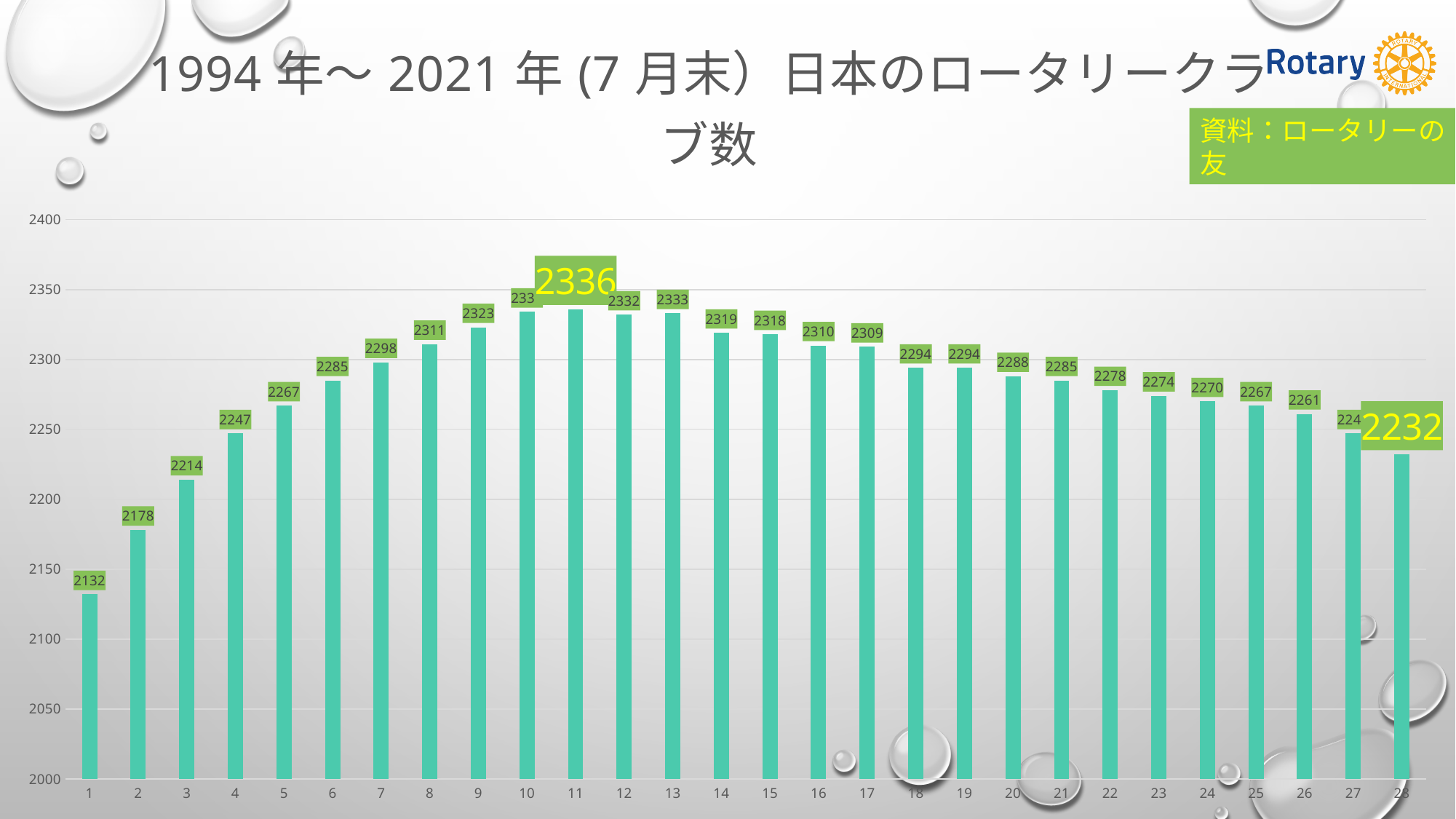
Which is larger, the value for category 5 or the value for category 22? category 22 What is the value for category 28? 2232 What is the value for category 1? 2132 How many bars (categories) are plotted on the chart? 28 What is the value for category 11? 2336 Which category has the highest value? 11 Which category has the lowest value? 1 Is the value for category 3 greater or less than 2200? greater What type of chart is shown on the slide? bar chart Do the values rise or fall from category 11 to category 28? fall What is the value for category 18? 2294 What is the difference between the value for category 11 and the value for category 28? 104